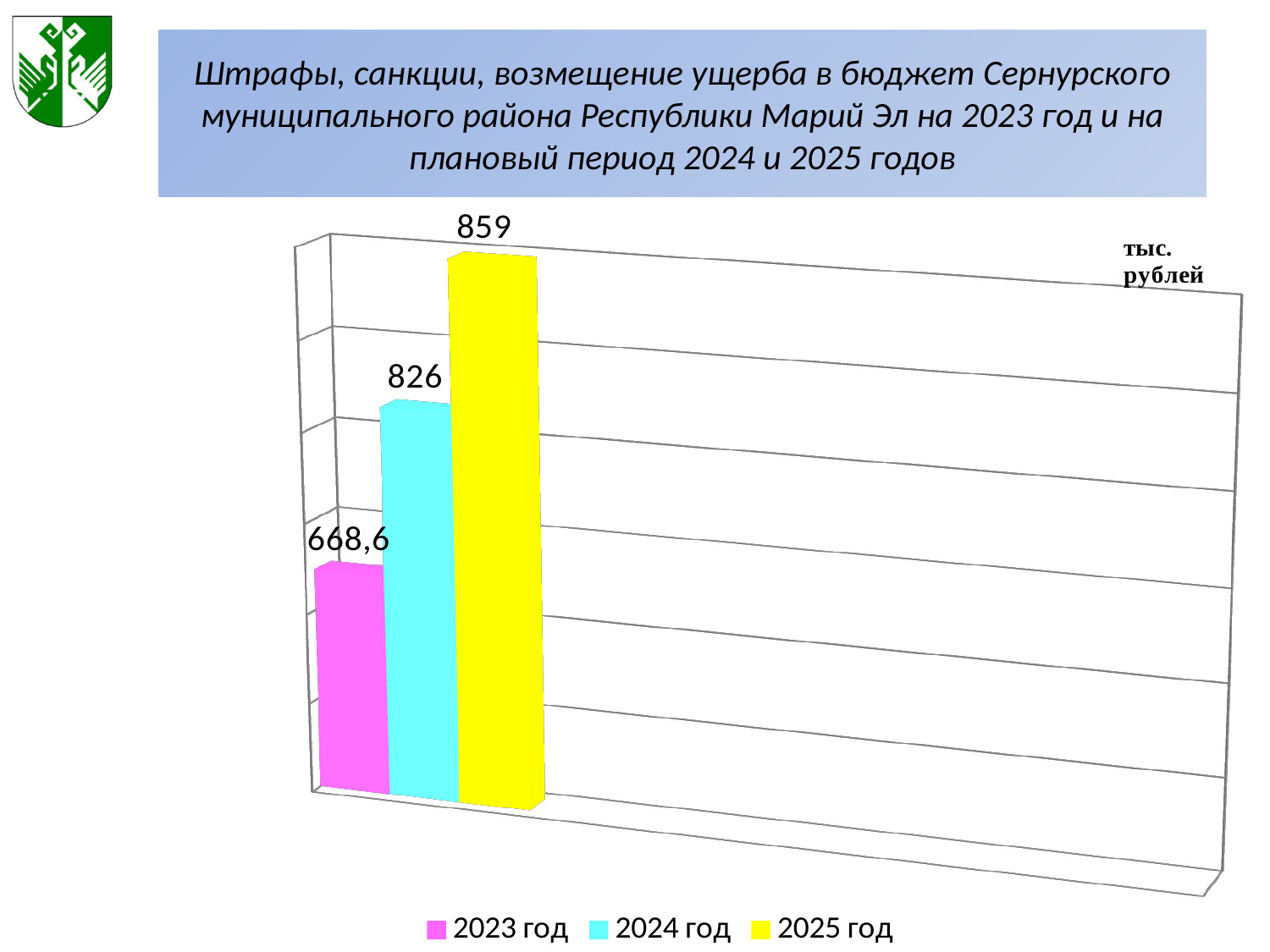
Which year has the lowest value? 2023 год Which year has the highest value? 2025 год Which is larger, the value for 2024 год or the value for 2023 год? 2024 год What is the value for 2025 год? 859 What is the difference between the values for 2025 год and 2024 год? 33 How many series does the legend list? 3 What is the value for 2023 год? 668,6 What is the value for 2024 год? 826 How many bars are plotted on the chart? 3 Do the values rise or fall from 2023 год to 2025 год? rise What kind of chart is shown on the slide? bar chart What is the difference between the values for 2024 год and 2023 год? 157,4